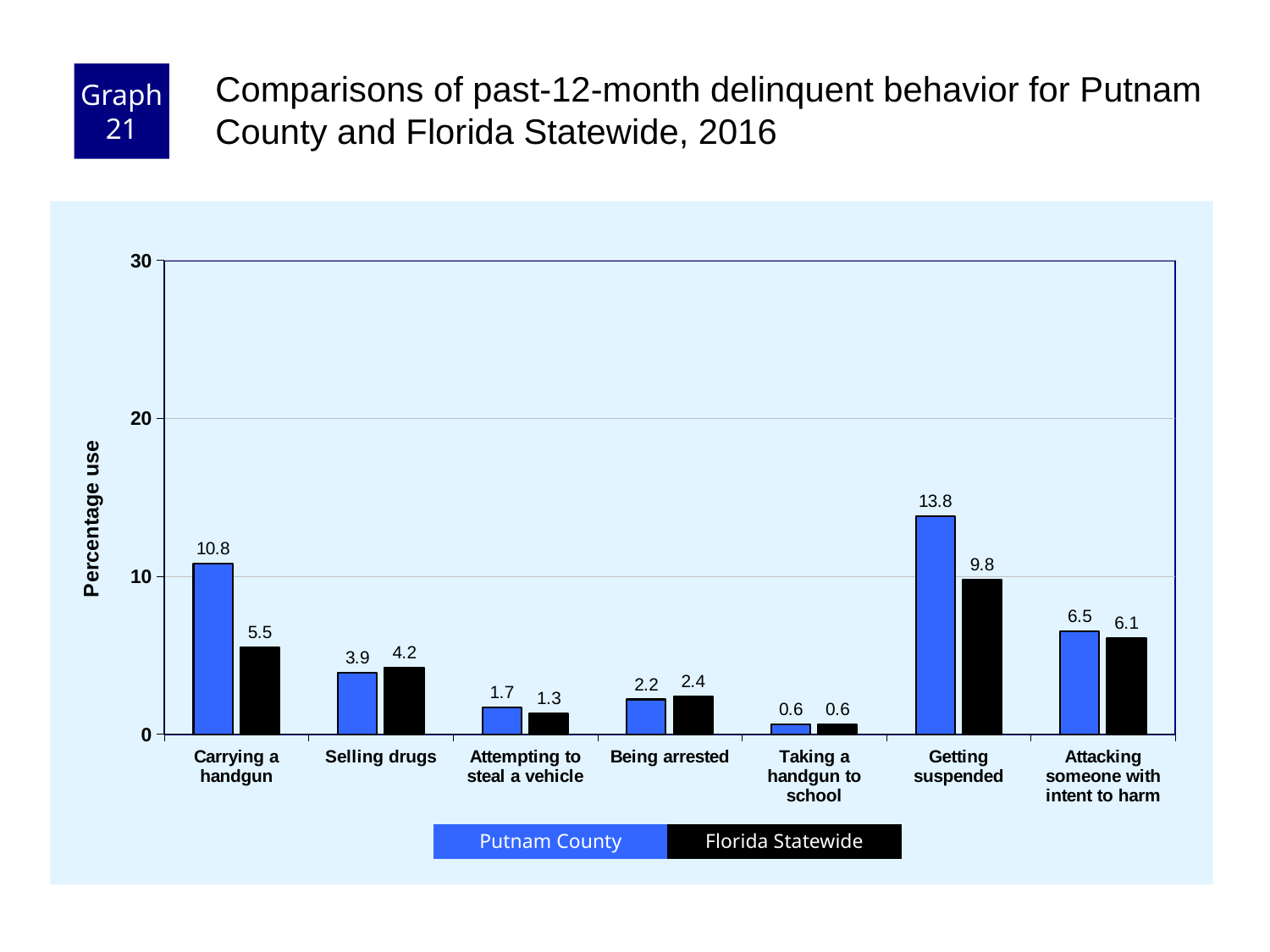
Which is larger for Selling drugs: Putnam County or Florida Statewide? Florida Statewide Is the Putnam County value for Getting suspended greater or less than 10? greater Which category has the highest Putnam County value? Getting suspended What is the difference between the Putnam County and Florida Statewide values for Carrying a handgun? 5.3 How many series does the legend list? 2 What is the Putnam County value for Attempting to steal a vehicle? 1.7 What is the label of the y axis? Percentage use What kind of chart is shown on the slide? bar chart How many categories are shown on the x axis? 7 What is the Florida Statewide value for Getting suspended? 9.8 What is the Putnam County value for Carrying a handgun? 10.8 Which category has the lowest Florida Statewide value? Taking a handgun to school